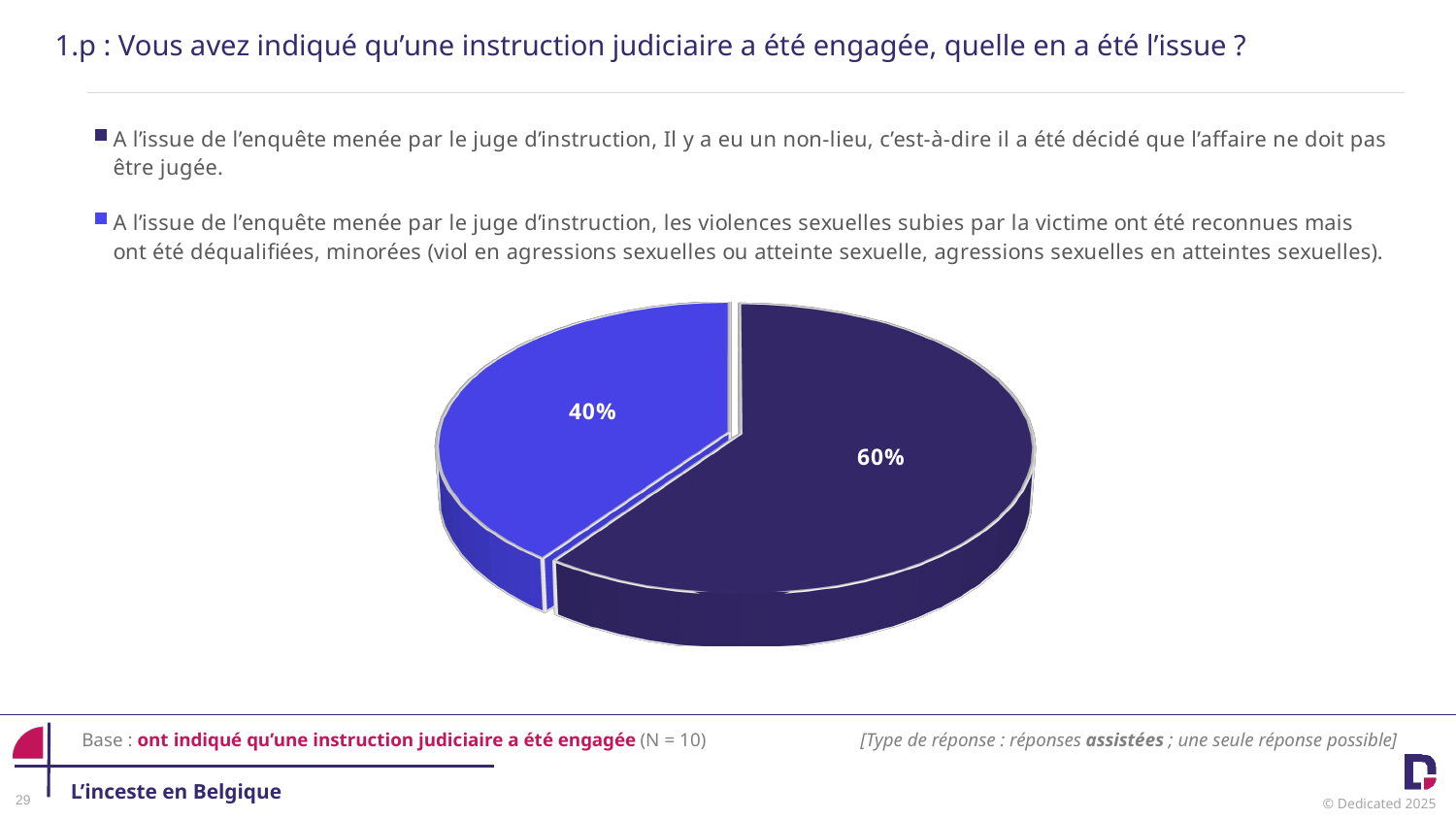
Which outcome has the largest share of the pie? Non-lieu (the case was not to be judged) What share of the pie is the dark navy slice? 60% Which is larger: the share for non-lieu or the share for requalified/minimised violence? Non-lieu What percentage of respondents said the sexual violence was recognised but requalified/minimised? 40% What percentage of respondents said the investigation ended in a non-lieu (the case was not to be judged)? 60% How many slices does the pie chart have? 2 How many entries does the legend list? 2 What is the base size (N) stated for this chart? N = 10 What share of the pie is the bright blue slice? 40% Which outcome has the smallest share of the pie? Violence recognised but requalified/minimised What kind of chart is shown on the slide? pie chart What is the difference in percentage points between the two slices of the pie? 20 percentage points